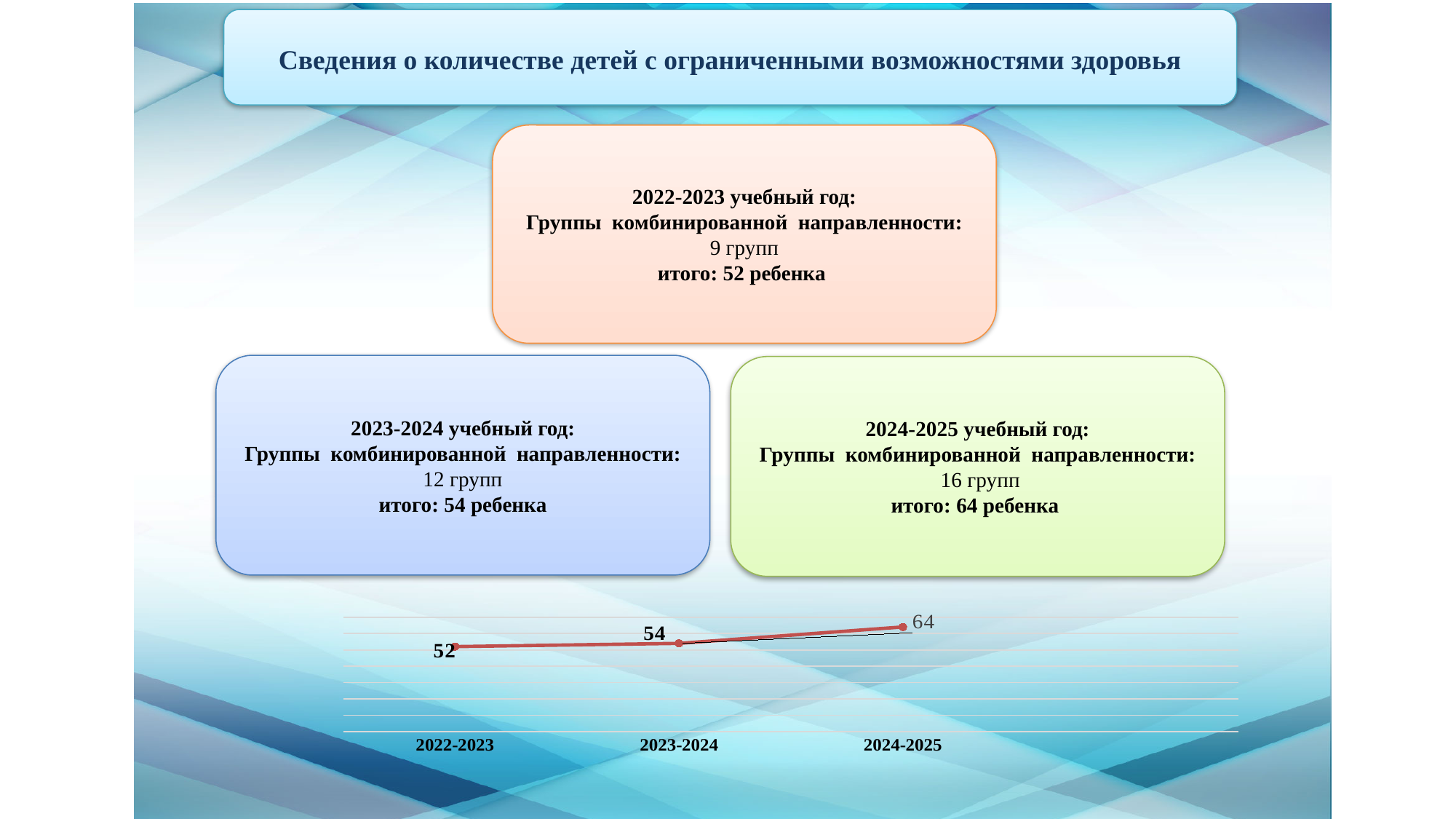
What is the difference between the values for 2024-2025 and 2023-2024? 10 Which year has the highest value on the chart? 2024-2025 Which year has the lowest value on the chart? 2022-2023 What type of chart is shown at the bottom of the slide? line chart What is the value plotted for 2022-2023? 52 Which is larger, the value for 2022-2023 or the value for 2024-2025? 2024-2025 What is the value plotted for 2024-2025? 64 How many data points are plotted on the line chart? 3 What colour is the line on the chart? red What is the value plotted for 2023-2024? 54 Do the values rise or fall from 2022-2023 to 2024-2025? rise What is the difference between the values for 2023-2024 and 2022-2023? 2